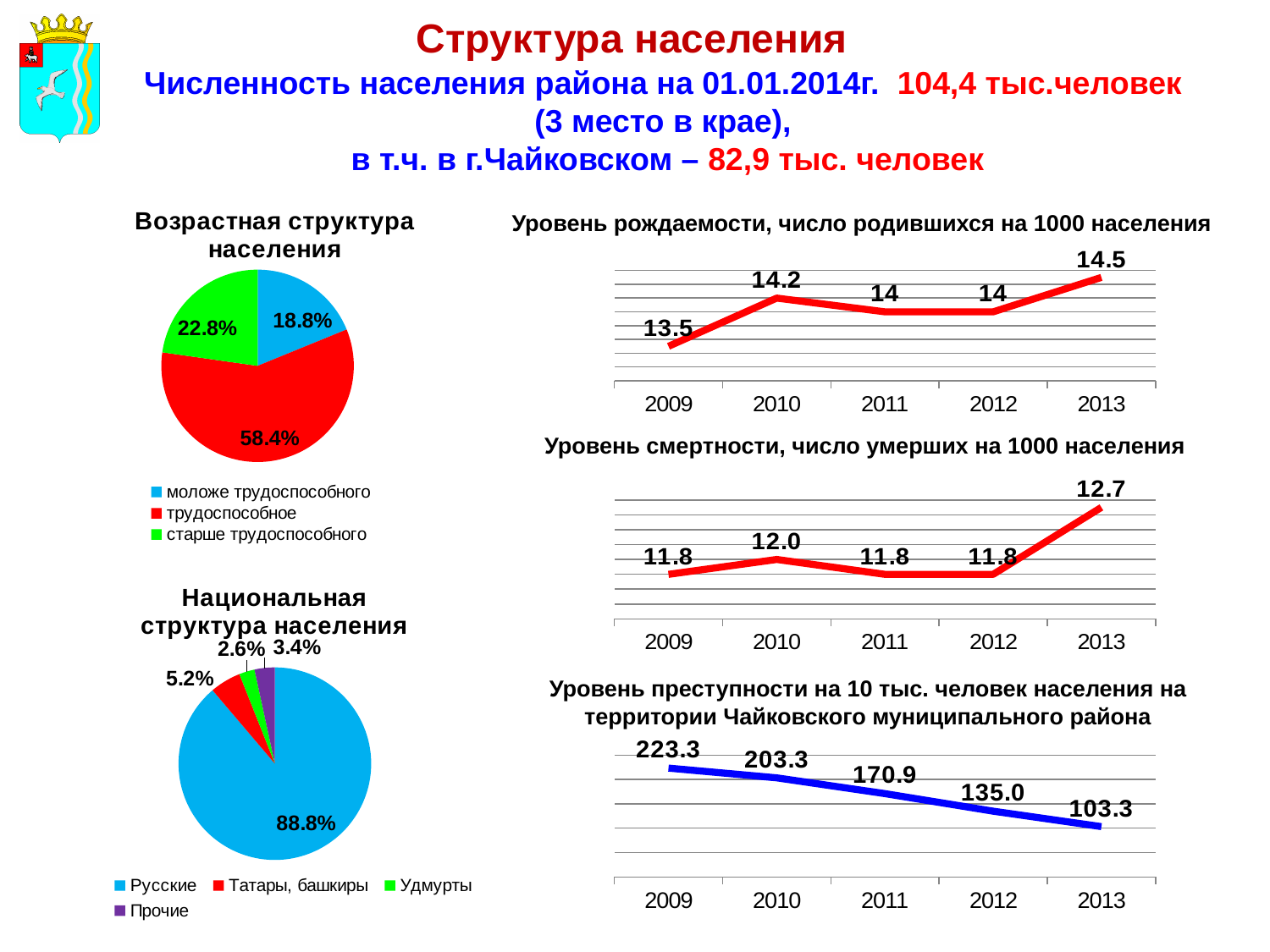
In the 'Уровень смертности' chart, what is the value for 2010? 12.0 In the 'Уровень преступности' chart, do the values rise or fall from 2009 to 2013? fall In the 'Уровень преступности' chart, what is the difference between the 2009 and 2013 values? 120.0 In the 'Уровень смертности' chart, which year has the highest value? 2013 In the 'Национальная структура населения' pie chart, what share is shown for 'Русские'? 88.8% In the 'Уровень рождаемости' chart, which year has the lowest value? 2009 In the 'Национальная структура населения' pie chart, what share is shown for 'Татары, башкиры'? 5.2% How many categories does the legend of the 'Национальная структура населения' pie chart list? 4 In the 'Возрастная структура населения' pie chart, which category has the smallest share? моложе трудоспособного In the 'Возрастная структура населения' pie chart, what share is labelled for the 'трудоспособное' slice? 58.4% In the 'Уровень рождаемости' chart, what is the value for 2013? 14.5 In the 'Уровень рождаемости' chart, what is the difference between the 2013 and 2009 values? 1